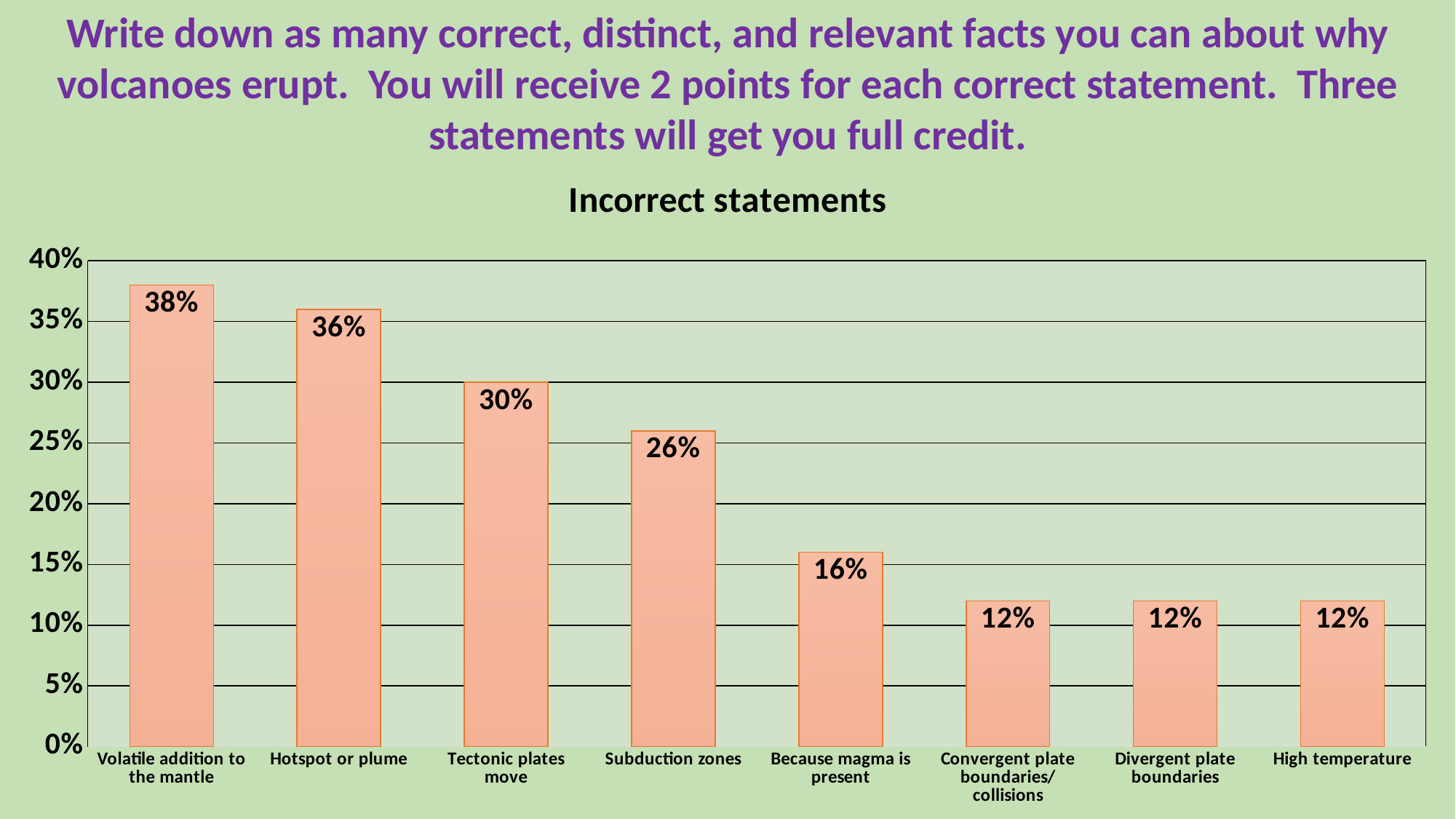
How many categories are shown on the chart? 8 What is the difference between "Subduction zones" and "High temperature"? 14% Which is larger, "Tectonic plates move" or "Because magma is present"? Tectonic plates move What is the value for "Because magma is present"? 16% What is the value for "Hotspot or plume"? 36% Do the values rise or fall from left to right along the x axis? Fall Which category has the highest value? Volatile addition to the mantle How many categories share the lowest value of 12%? 3 What is the difference between "Volatile addition to the mantle" and "Tectonic plates move"? 8% What kind of chart is shown? Bar chart What is the title of the chart? Incorrect statements What is the value for "Subduction zones"? 26%